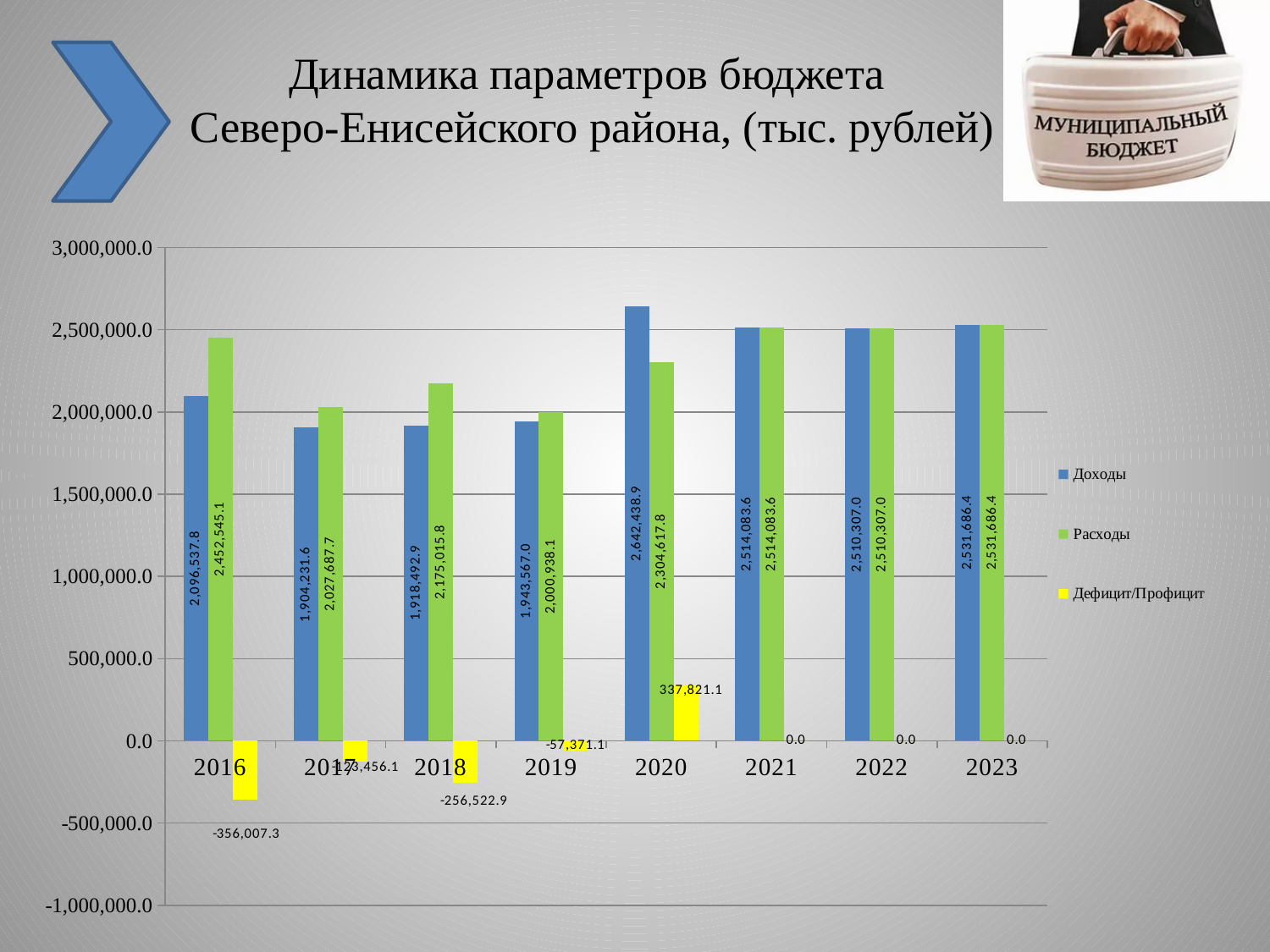
In 2019, which is larger: Доходы or Расходы? Расходы How many series does the legend list? 3 By how much do Расходы exceed Доходы in 2016? 356,007.3 What is the value of Дефицит/Профицит for 2020? 337,821.1 Which year has the highest value of Доходы? 2020 Which year has the highest value of Расходы? 2023 Which year has the lowest value of Доходы? 2017 What is the value of Расходы for 2018? 2,175,015.8 What is the value of Доходы for 2016? 2,096,537.8 What is the value of Дефицит/Профицит for 2021? 0.0 Is the value of Расходы for 2020 greater or less than 2,500,000.0? less How many years are shown on the x axis? 8